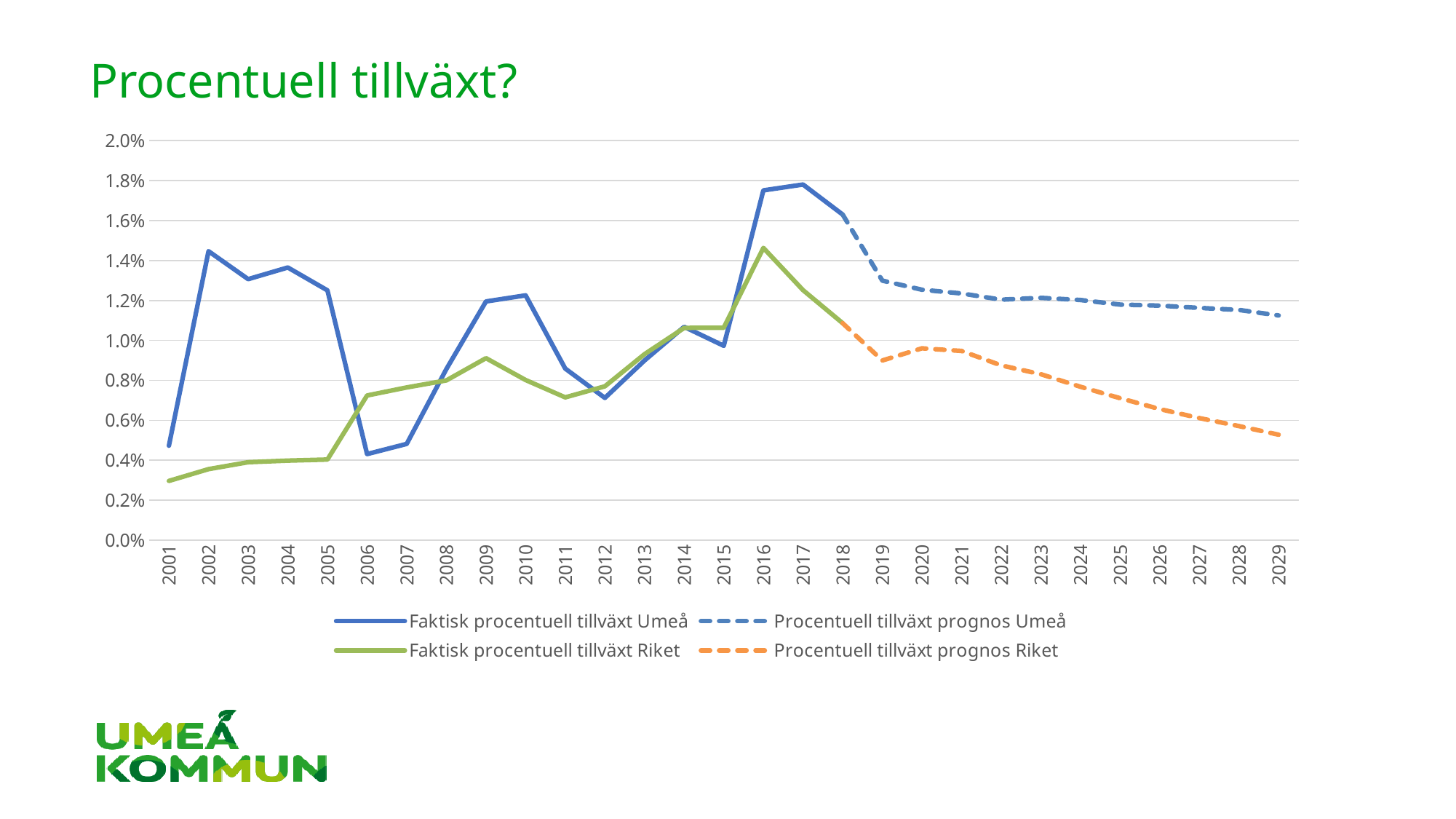
Does the Procentuell tillväxt prognos Riket series rise or fall from 2020 to 2029? fall How many years are shown on the x axis? 29 What is the title of the chart? Procentuell tillväxt? What kind of chart is shown on the slide? line chart Is the value for Procentuell tillväxt prognos Riket in 2029 greater or less than 0.6%? less Is the value for Faktisk procentuell tillväxt Umeå in 2006 greater or less than 0.6%? less How many series does the legend list? 4 In which year is the value for Faktisk procentuell tillväxt Riket highest? 2016 In which year is the value for Faktisk procentuell tillväxt Riket lowest? 2001 Is the value for Faktisk procentuell tillväxt Umeå in 2002 greater or less than 1.4%? greater In 2006, which is larger: Faktisk procentuell tillväxt Umeå or Faktisk procentuell tillväxt Riket? Faktisk procentuell tillväxt Riket